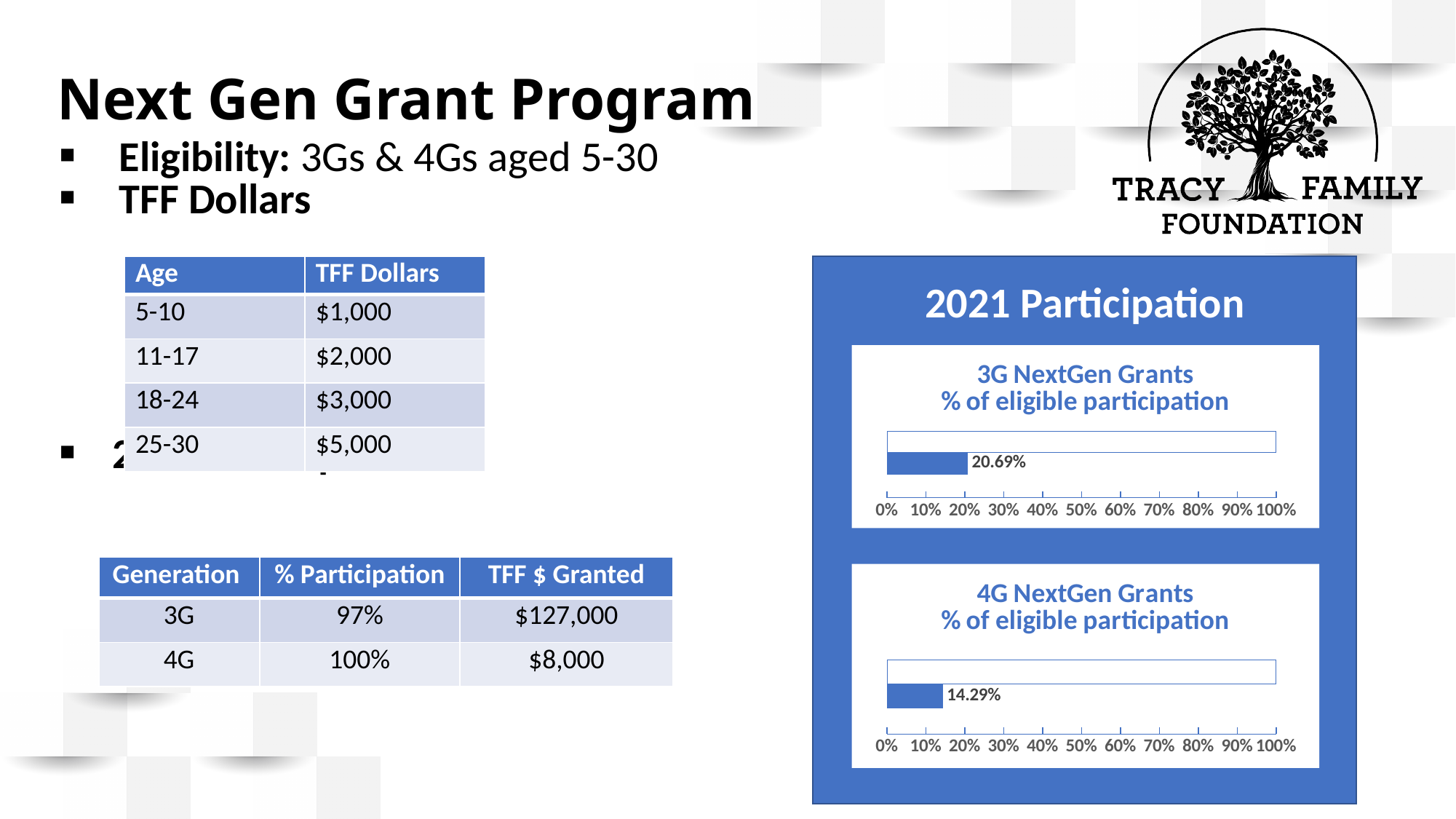
In the '3G NextGen Grants % of eligible participation' chart, what is the maximum value shown on the x axis? 100% What kind of chart is the '3G NextGen Grants % of eligible participation' chart? bar chart In the '3G NextGen Grants % of eligible participation' chart, is the bar value greater or less than 30%? less In the '4G NextGen Grants % of eligible participation' chart, is the bar value greater or less than 10%? greater In the '3G NextGen Grants % of eligible participation' chart, what value is shown for the bar? 20.69% What is the title of the blue panel that contains the two charts on the right of the slide? 2021 Participation Which chart shows the higher participation value, the 3G NextGen Grants chart or the 4G NextGen Grants chart? 3G NextGen Grants What kind of chart is the '4G NextGen Grants % of eligible participation' chart? bar chart In the '4G NextGen Grants % of eligible participation' chart, what value is shown for the bar? 14.29% What is the difference between the 3G NextGen Grants participation value and the 4G NextGen Grants participation value? 6.40% In the '4G NextGen Grants % of eligible participation' chart, is the bar value greater or less than 20%? less